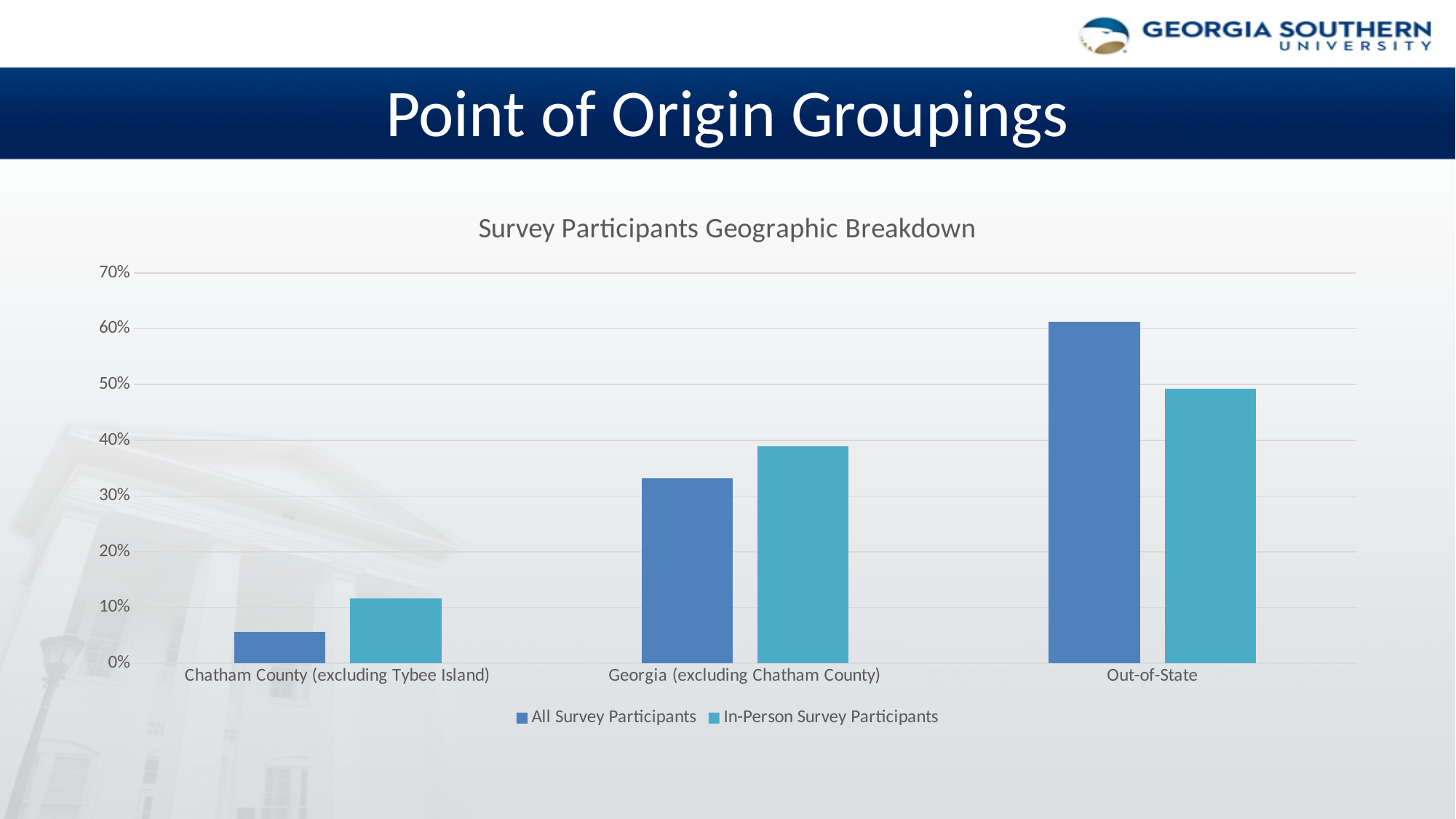
Do the values for All Survey Participants rise or fall from left to right across the categories? rise For Out-of-State, which series has the larger value: All Survey Participants or In-Person Survey Participants? All Survey Participants Which category has the highest value for All Survey Participants? Out-of-State For Georgia (excluding Chatham County), which series has the larger value: All Survey Participants or In-Person Survey Participants? In-Person Survey Participants Is the value for All Survey Participants in Chatham County (excluding Tybee Island) greater or less than 10%? less Is the value for In-Person Survey Participants in Out-of-State greater or less than 50%? less What is the title of the chart? Survey Participants Geographic Breakdown Is the value for All Survey Participants in Out-of-State greater or less than 60%? greater What kind of chart is shown on the slide? bar chart Which category has the lowest value for In-Person Survey Participants? Chatham County (excluding Tybee Island) How many categories are shown on the x axis? 3 How many series does the legend list? 2